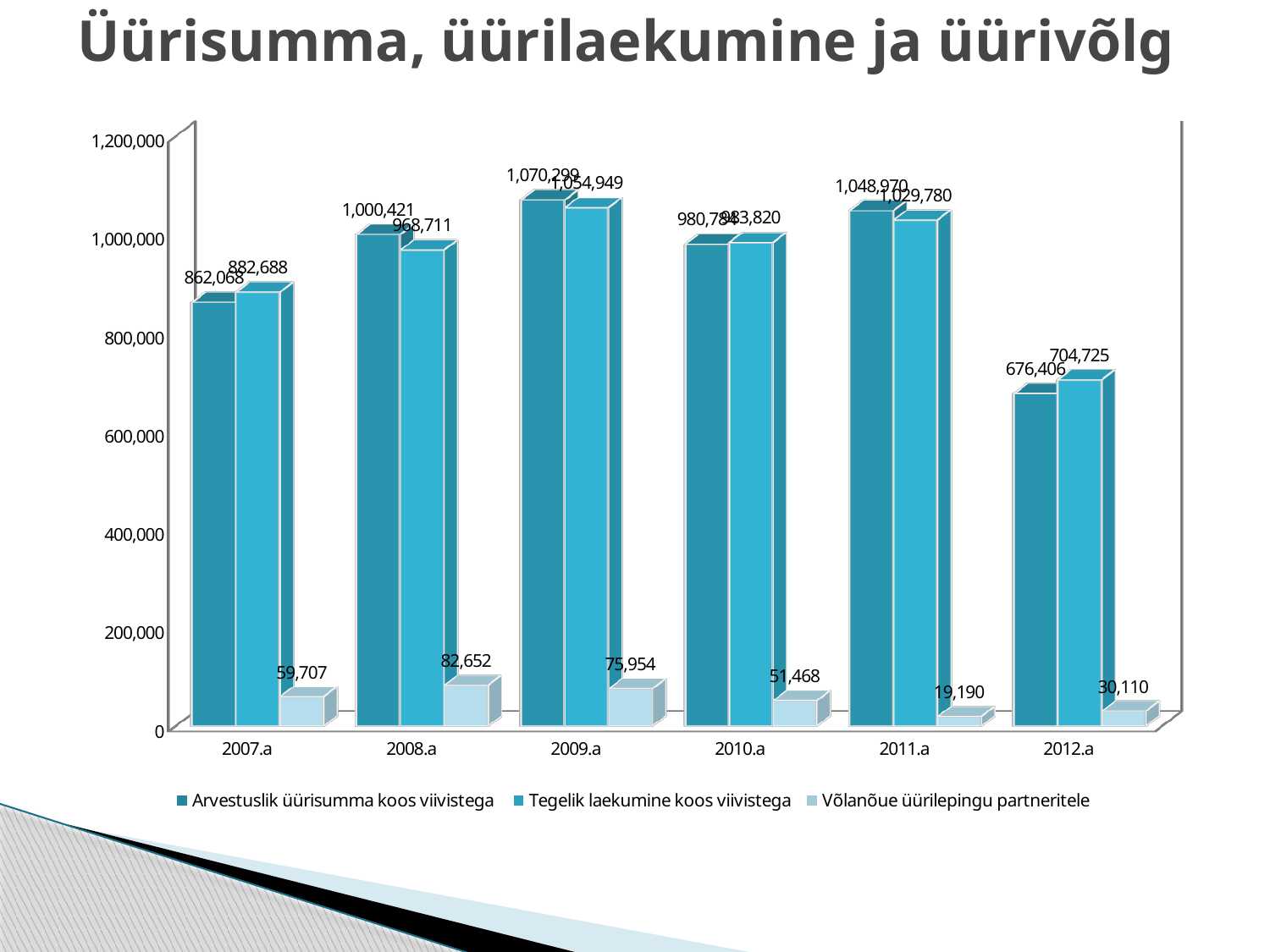
How many years are shown on the x axis? 6 For 2007.a, how much larger is Tegelik laekumine koos viivistega than Arvestuslik üürisumma koos viivistega? 20,620 In which year is Võlanõue üürilepingu partneritele the lowest? 2011.a For 2012.a, which is larger: Arvestuslik üürisumma koos viivistega or Tegelik laekumine koos viivistega? Tegelik laekumine koos viivistega How many series does the legend list? 3 What kind of chart is shown on the slide? Bar chart Is the value of Arvestuslik üürisumma koos viivistega for 2012.a greater or less than 800,000? less What is the value of Võlanõue üürilepingu partneritele for 2008.a? 82,652 What is the value of Arvestuslik üürisumma koos viivistega for 2009.a? 1,070,299 In which year is Võlanõue üürilepingu partneritele the highest? 2008.a In which year is Arvestuslik üürisumma koos viivistega the highest? 2009.a What is the value of Tegelik laekumine koos viivistega for 2012.a? 704,725